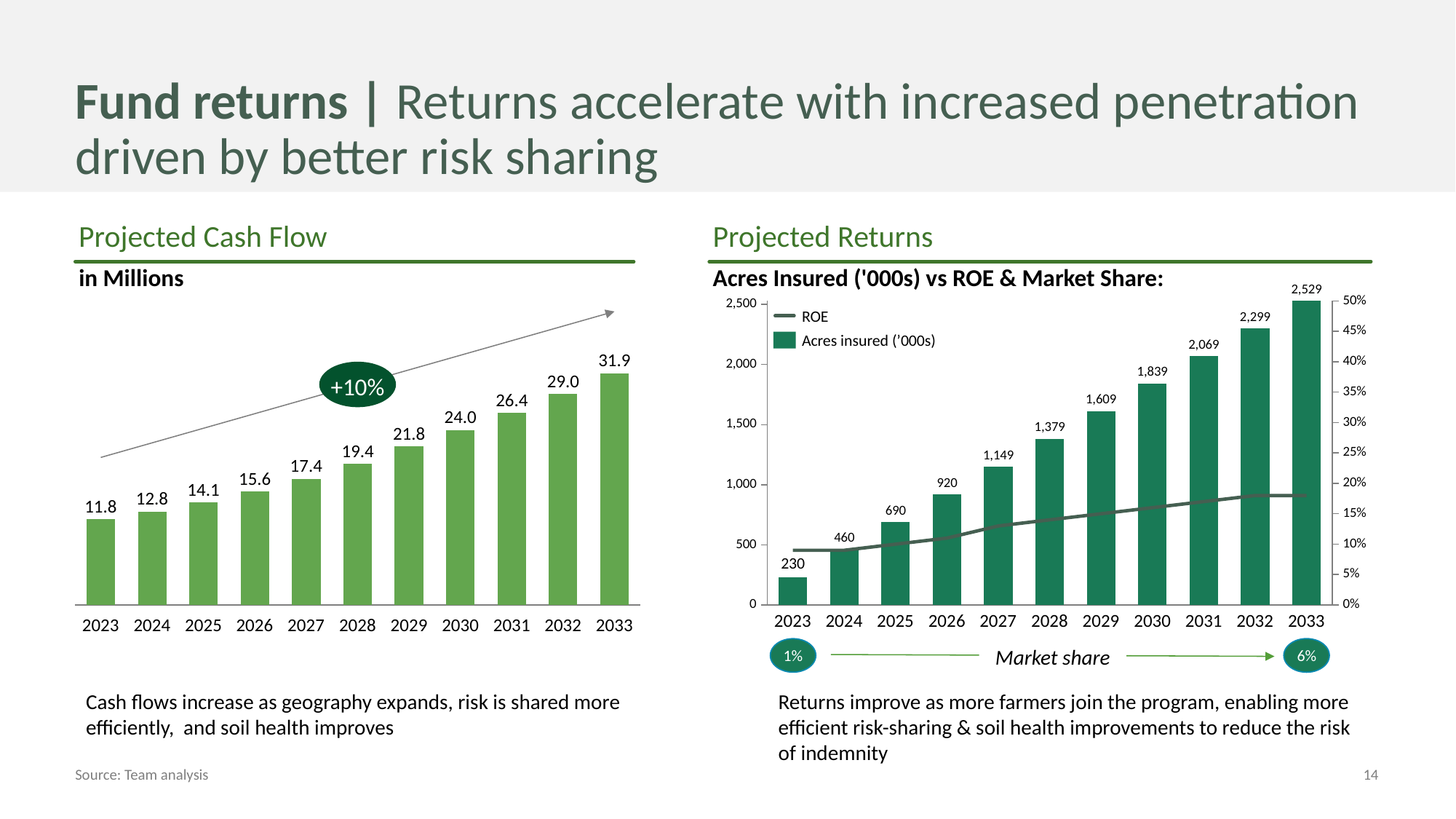
In the Projected Cash Flow chart, do the values rise or fall from 2023 to 2033? rise In the Projected Cash Flow chart, what is the difference between the 2033 and 2023 values? 20.1 In the Projected Returns chart, how many acres insured ('000s) are shown for 2027? 1,149 In the Projected Cash Flow chart, what is the value for 2028? 19.4 In the Projected Returns chart, how many series does the legend list? 2 In the Projected Returns chart, is the ROE value for 2033 greater or less than 15%? greater In the Projected Returns chart, which year has the lowest acres insured? 2023 In the Projected Cash Flow chart, how many years are plotted? 11 In the Projected Returns chart, what is the difference in acres insured between 2033 and 2032? 230 What type of chart is the Projected Cash Flow chart? bar chart In the Projected Cash Flow chart, what growth rate is shown in the oval on the arrow? +10% In the Projected Cash Flow chart, which year has the highest value? 2033